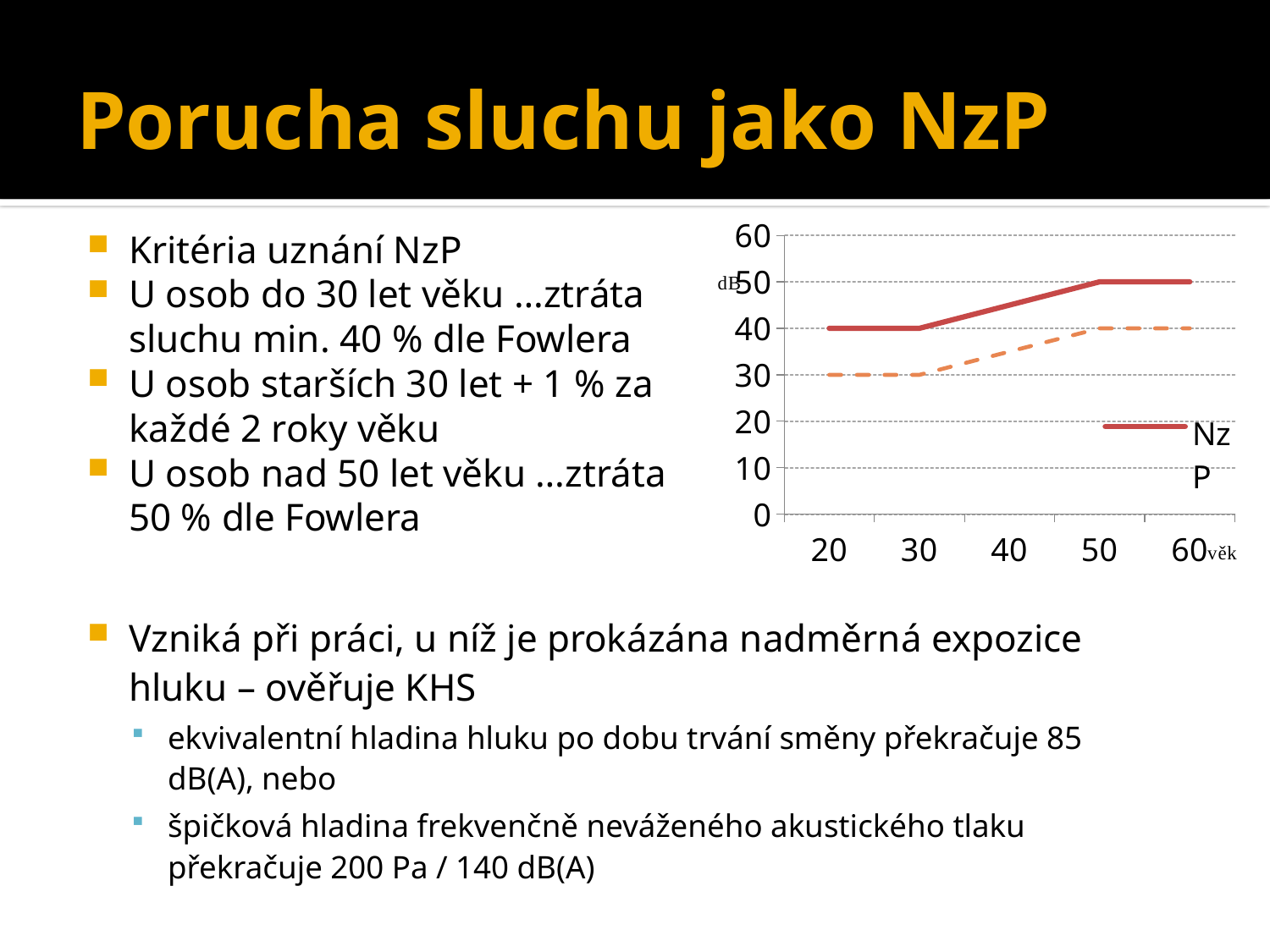
At age 40, which series has the higher value, Nz or P? Nz Is the value of the Nz series at age 40 greater or less than 40? greater How many age values are marked on the x axis of the chart? 5 Do the values of the Nz series rise or fall as age increases from 20 to 60? rise What is the value of the Nz series at age 20? 40 What is the value of the P series at age 20? 30 How many series does the chart legend list? 2 What is the difference between the Nz and P values at age 60? 10 What kind of chart is shown on the slide? line chart What is the value of the Nz series at age 60? 50 What is the value of the P series at age 50? 40 What are the two entries in the chart legend? Nz and P